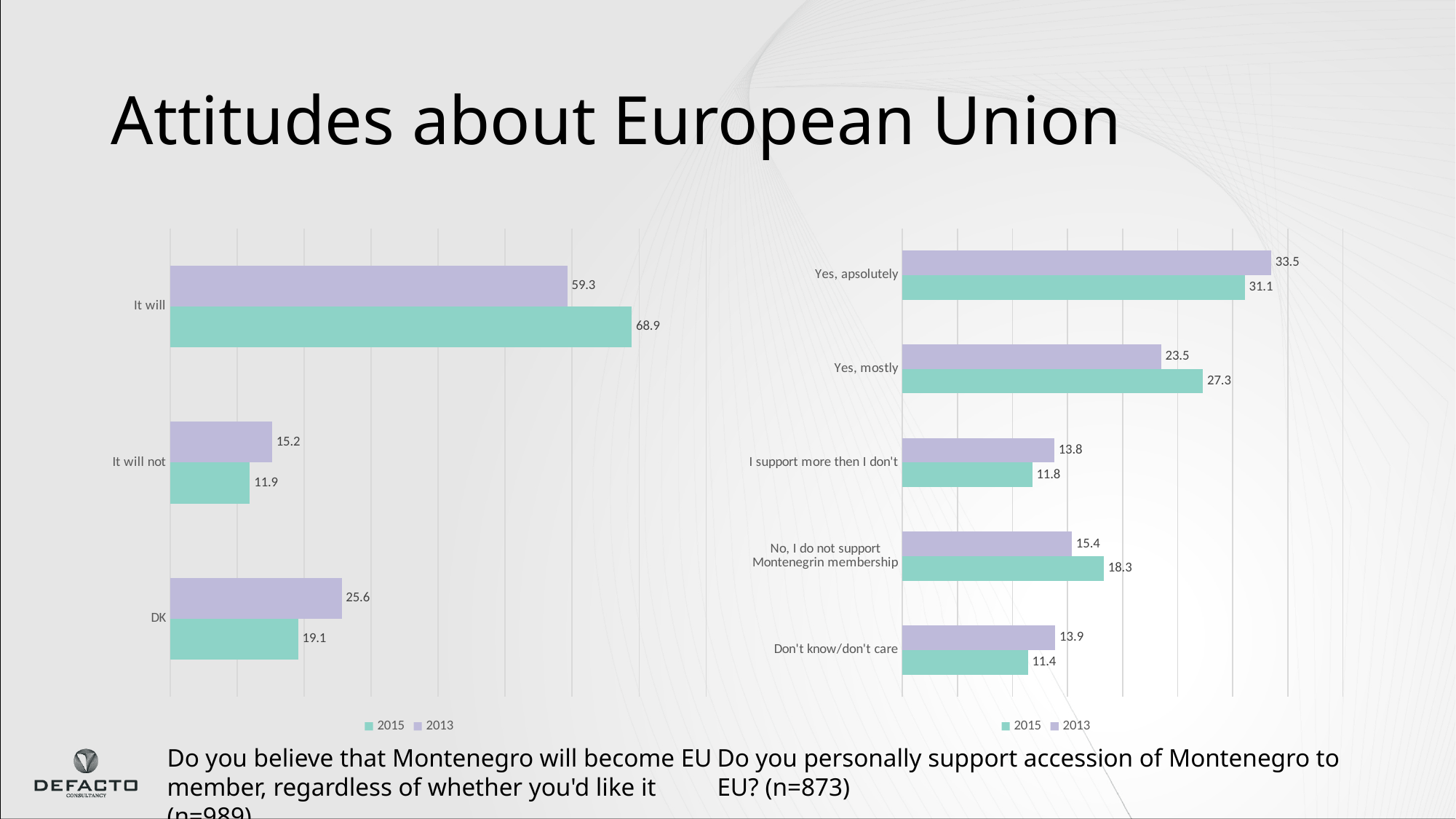
In the left chart, which category has the lowest 2015 value? It will not In the left chart, what is the difference between the 2015 and 2013 values for "It will"? 9.6 In the right chart, what is the difference between the 2015 and 2013 values for "Yes, mostly"? 3.8 In the right chart, which is larger for "Don't know/don't care": the 2015 value or the 2013 value? 2013 How many categories does the right chart show? 5 In the right chart, which category has the highest 2015 value? Yes, apsolutely In the left chart, what is the 2015 value for "It will"? 68.9 In the right chart, what is the 2013 value for "Yes, apsolutely"? 33.5 How many series does the legend of the left chart list? 2 What type of chart is the left chart? Bar chart In the right chart, what is the 2015 value for "No, I do not support Montenegrin membership"? 18.3 In the left chart, what is the 2013 value for "DK"? 25.6